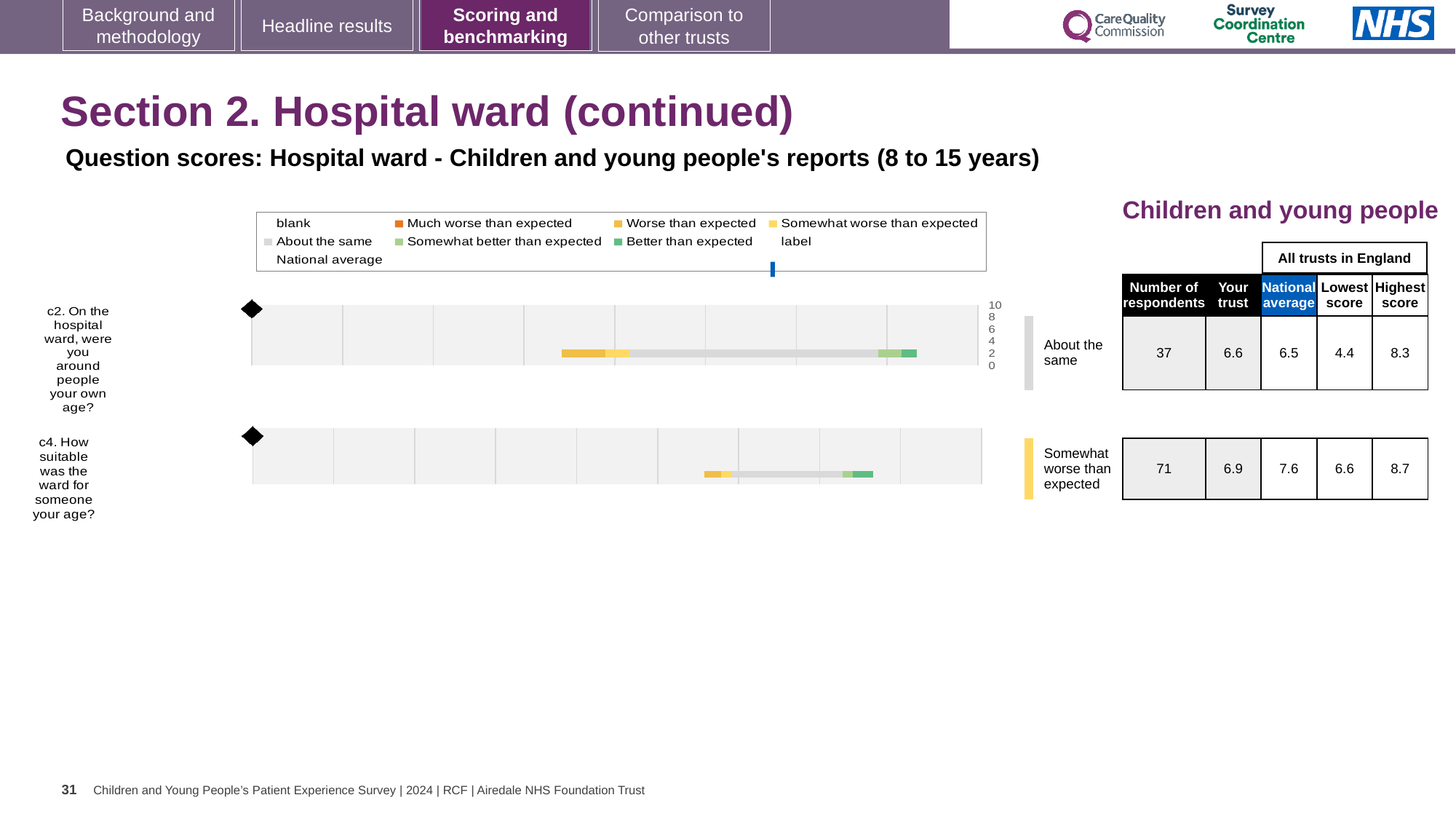
What is the 'Your trust' score for question c4 (How suitable was the ward for someone your age?)? 6.9 What kind of chart is used to show the question scores for c2 and c4? bar chart How many respondents answered question c4? 71 What is the national average score for question c2? 6.5 What benchmark category is shown for question c4? Somewhat worse than expected What is the lowest score among all trusts in England for question c2? 4.4 What is the highest score among all trusts in England for question c4? 8.7 Which question has the higher 'Your trust' score, c2 or c4? c4 For question c4, how much higher is the national average than the trust's score? 0.7 What is the 'Your trust' score for question c2 (On the hospital ward, were you around people your own age?)? 6.6 How many questions (bars) are plotted on the chart? 2 What is the national average score for question c4? 7.6